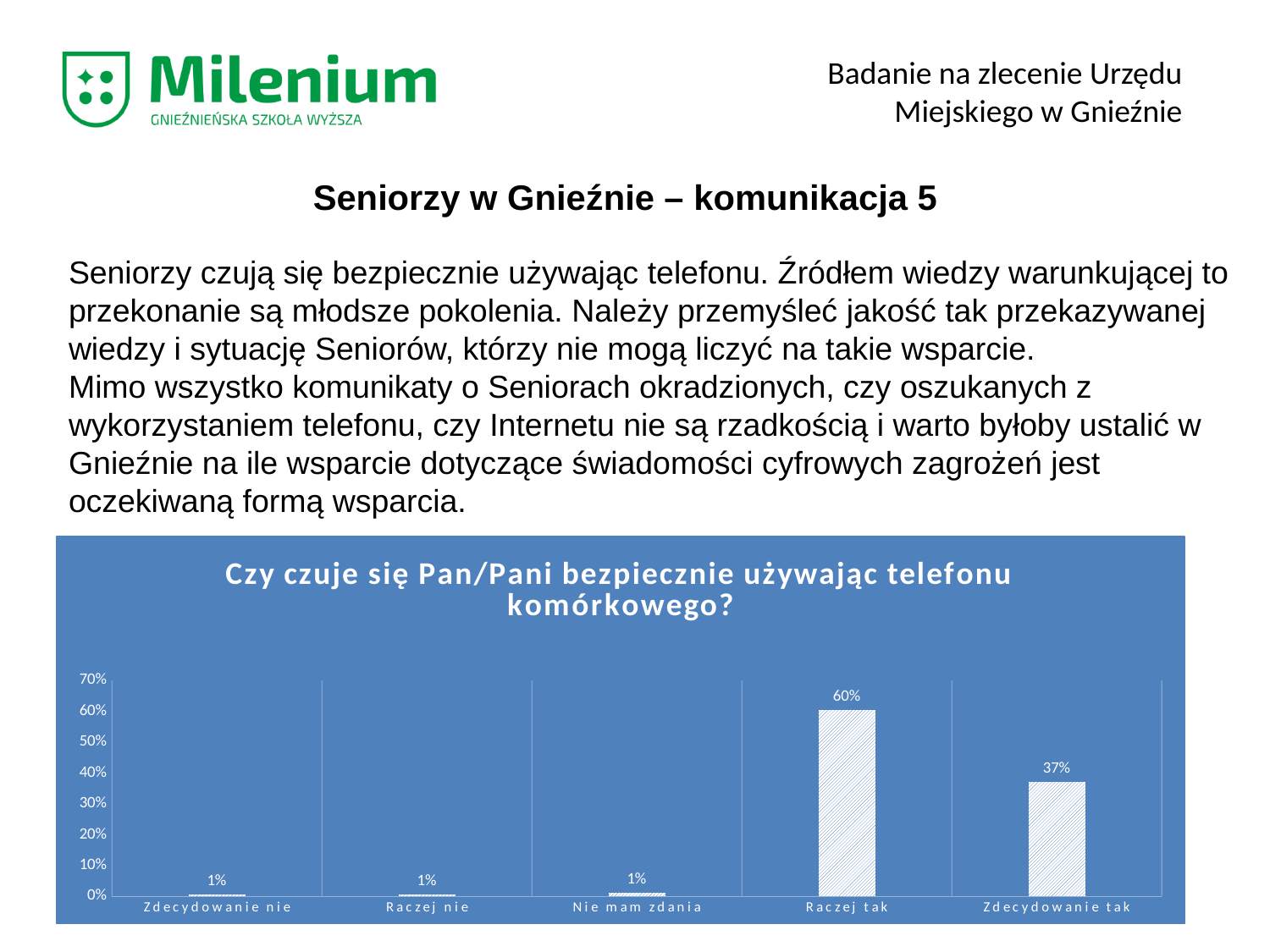
Which is larger, the value for "Raczej tak" or the value for "Zdecydowanie tak"? Raczej tak Is the value for "Raczej tak" greater or less than 50%? greater What is the value for "Raczej tak"? 60% How many categories are shown on the x axis? 5 What is the difference between the values for "Raczej tak" and "Zdecydowanie tak"? 23% What is the value for "Zdecydowanie tak"? 37% Is the value for "Zdecydowanie tak" greater or less than 40%? less Which category has the highest value? Raczej tak What kind of chart is shown on the slide? bar chart What is the title of the chart? Czy czuje się Pan/Pani bezpiecznie używając telefonu komórkowego? What is the value for "Nie mam zdania"? 1% What is the highest value shown on the y axis? 70%